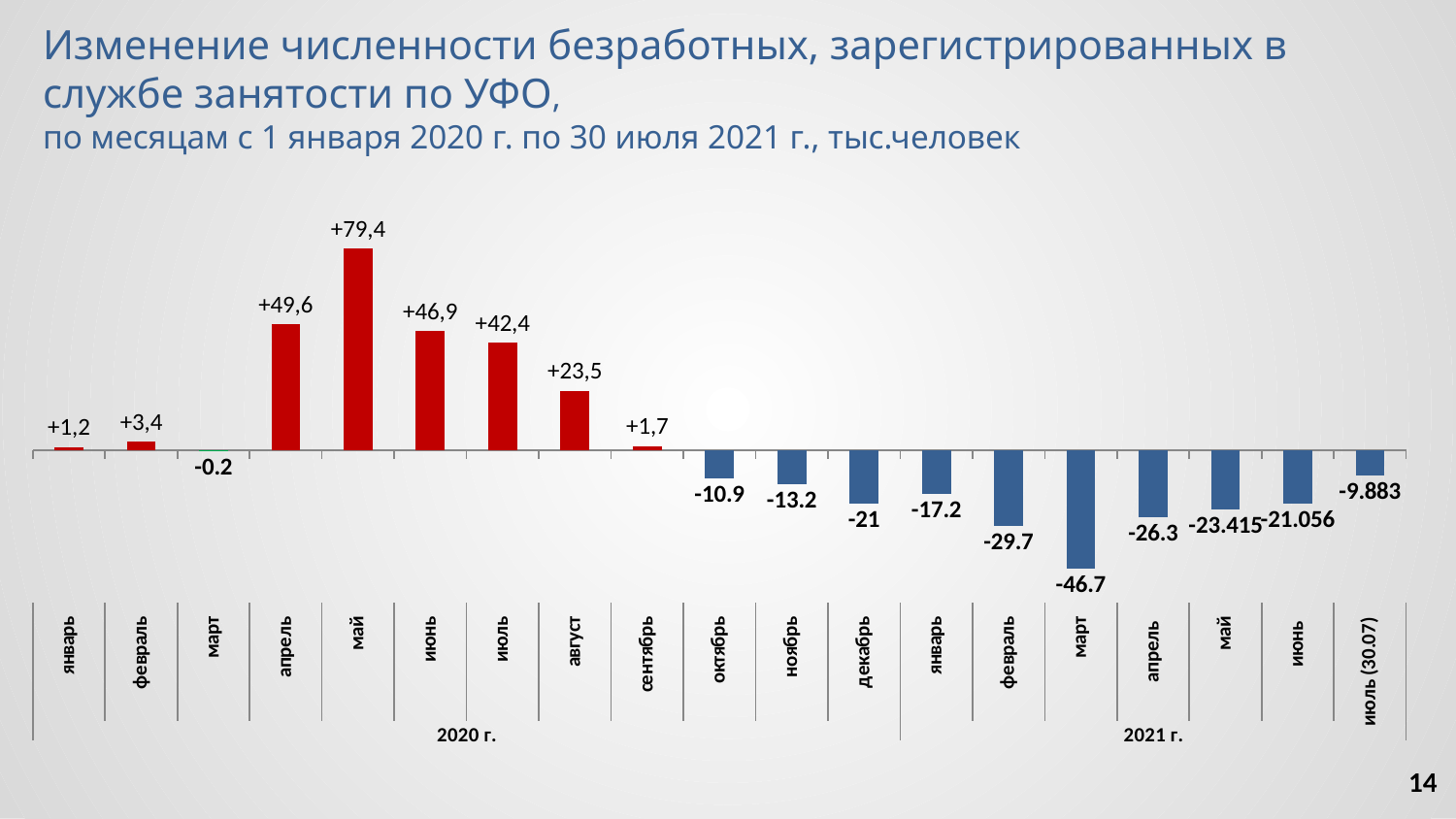
Which month has the lowest value on the chart? март 2021 г. What is the value for May 2020? +79,4 What type of chart is shown on the slide? Bar chart How many months (bars) are shown on the chart? 19 What is the difference between the values for April 2020 and June 2020? 2,7 Which month has the highest value on the chart? май 2020 г. Do the values rise or fall from May 2020 to September 2020? Fall What is the value for March 2021? -46.7 Which is larger, the value for July 2020 or the value for August 2020? July 2020 What is the value for December 2020? -21 What colour are the bars with negative values? Blue What is the value for July (30.07) 2021? -9.883